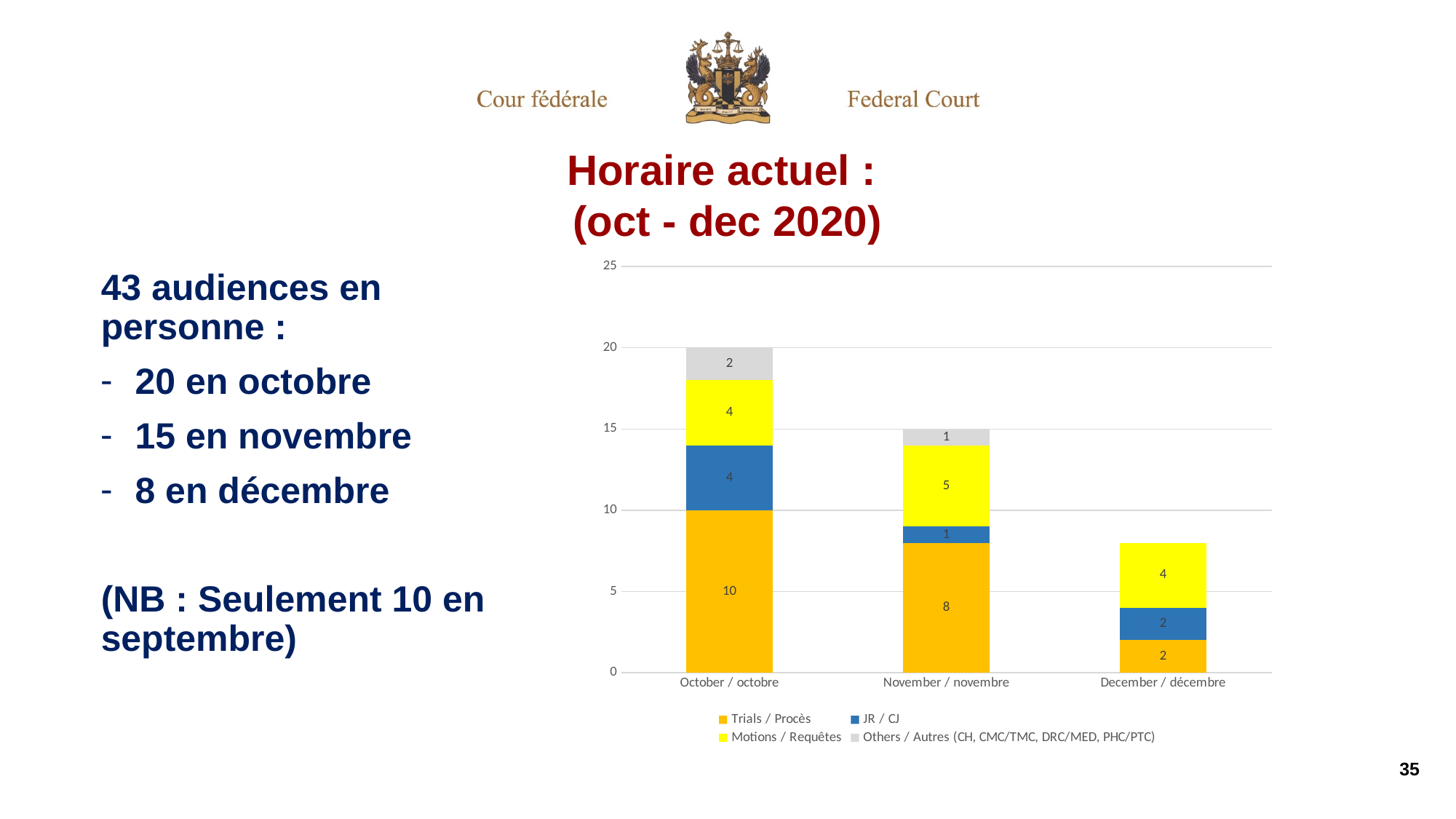
What is the total of the stacked bar for October / octobre? 20 Which month has the lowest total stacked bar? December / décembre What is the value for Trials / Procès in October / octobre? 10 What kind of chart is shown on the slide? Stacked bar chart What is the value for JR / CJ in December / décembre? 2 What is the value for Motions / Requêtes in November / novembre? 5 How many months are shown on the x axis? 3 Which month has the highest total stacked bar? October / octobre How many series does the legend list? 4 Is the JR / CJ value larger in October / octobre or in November / novembre? October / octobre What is the total of the stacked bar for December / décembre? 8 What is the difference between the Trials / Procès values for October / octobre and November / novembre? 2